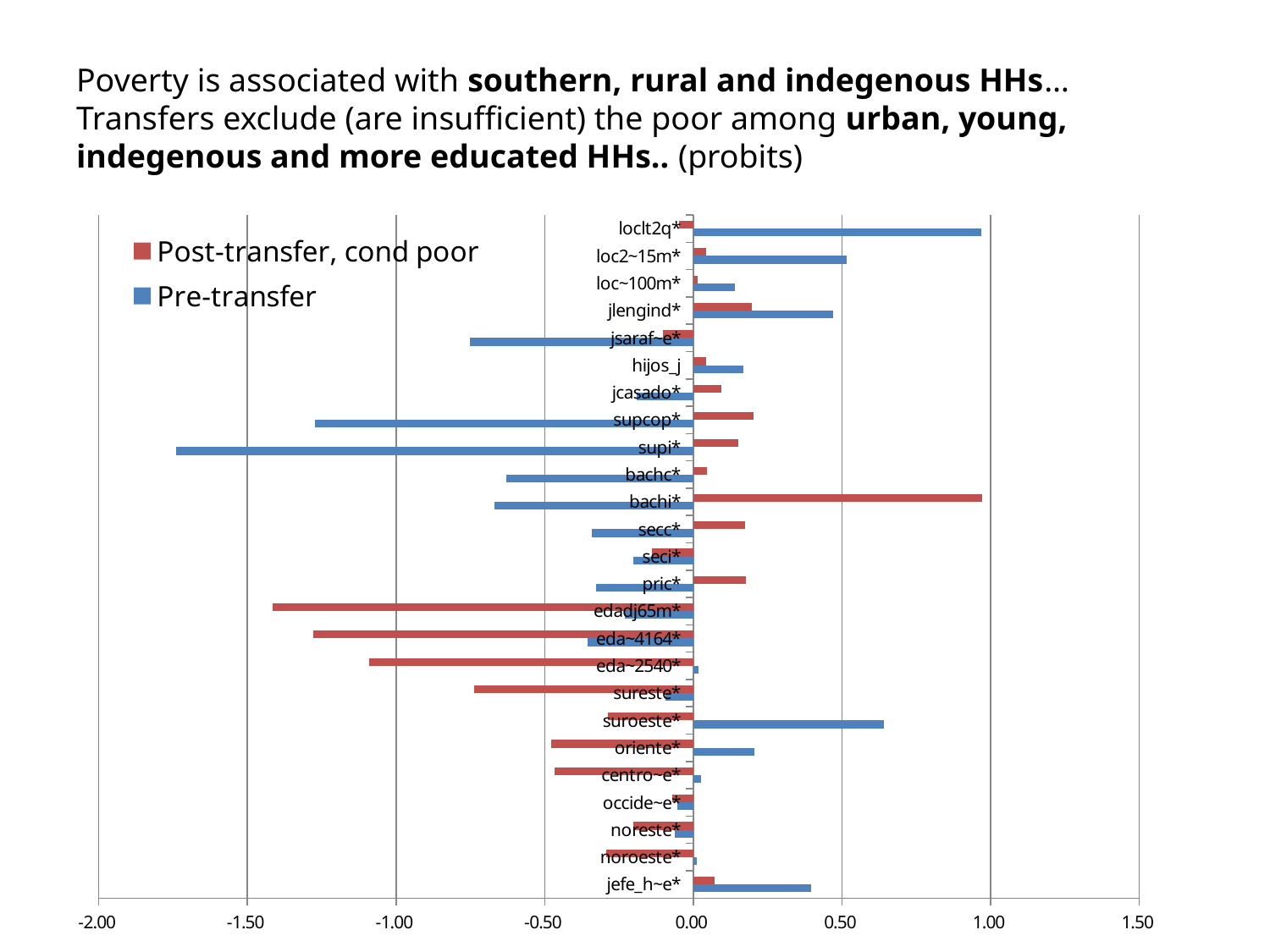
Is the Pre-transfer value for loclt2q* greater or less than 0.50? greater Which is larger: the Pre-transfer value for loclt2q* or the Pre-transfer value for suroeste*? loclt2q* Is the Pre-transfer value for supi* greater or less than -1.50? less How many categories are plotted on the vertical axis? 25 Which category has the lowest Pre-transfer value? supi* What kind of chart is shown on the slide? bar chart Which category has the highest Pre-transfer value? loclt2q* What colour represents the Pre-transfer series in the legend? blue Which category has the highest Post-transfer, cond poor value? bachi* Which category has the lowest Post-transfer, cond poor value? edadj65m* How many series does the legend list? 2 Is the Post-transfer, cond poor value for edadj65m* greater or less than -1.00? less